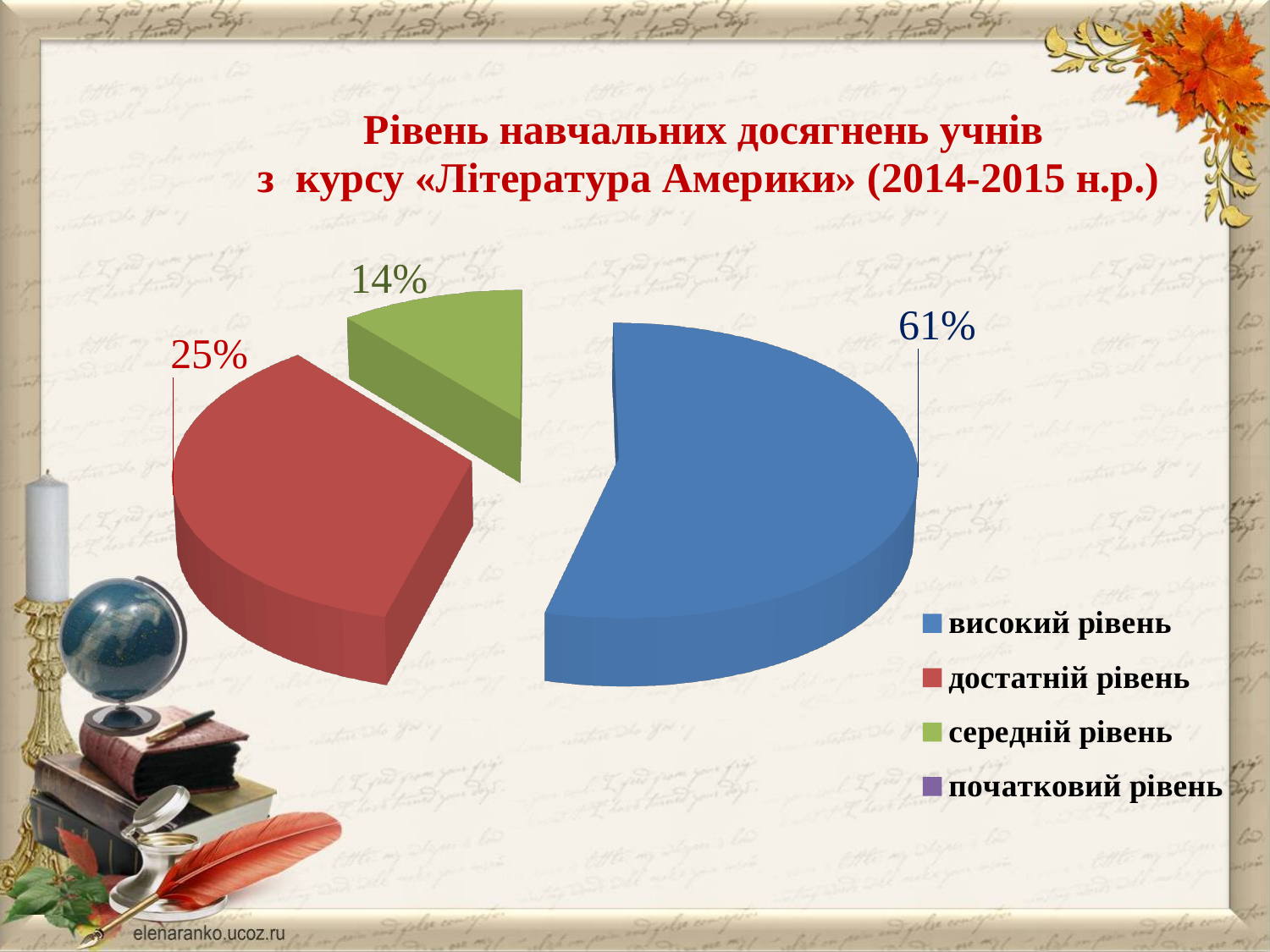
What share of the pie does "високий рівень" have? 61% Which category has the largest slice of the pie? високий рівень How many entries does the legend list? 4 What share of the pie does "середній рівень" have? 14% What share of the pie does "достатній рівень" have? 25% What is the difference between the shares of "високий рівень" and "достатній рівень"? 36 percentage points Which is larger, the slice for "достатній рівень" or the slice for "середній рівень"? достатній рівень What is the difference between the shares of "достатній рівень" and "середній рівень"? 11 percentage points What type of chart is shown on the slide? pie chart Which of the visible slices is the smallest? середній рівень How many slices are visible in the pie chart? 3 What colour is the slice for "високий рівень"? blue